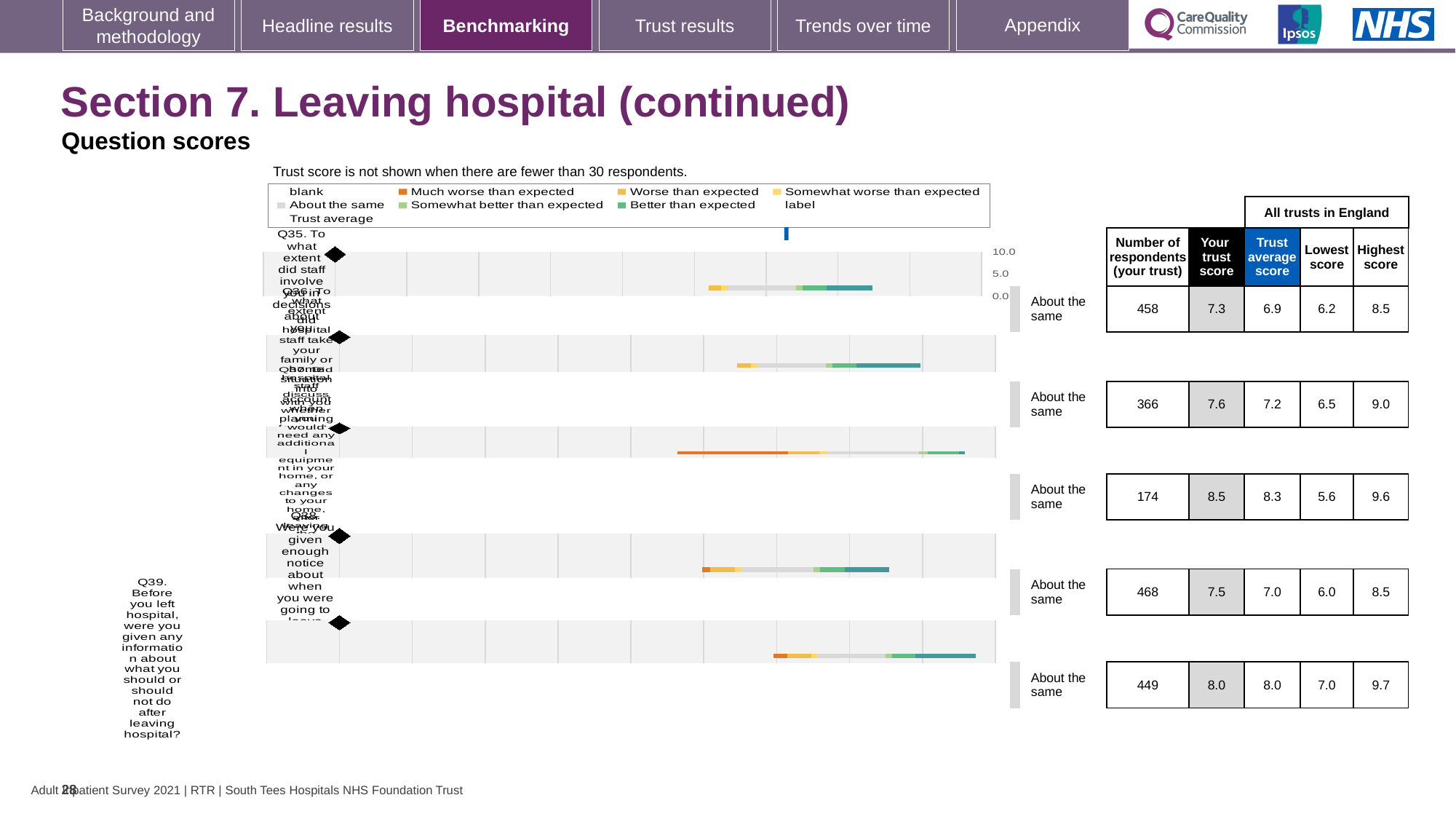
What kind of chart is used to show the question scores on this slide? bar chart Is the trust score for the fourth question (Q38) greater or less than 5.0? greater What is the trust average score for the second question (Q36)? 7.2 What is the highest value shown on the chart's score axis? 10.0 What is the difference between the trust score and the trust average score for the third question (Q37)? 0.2 Which question has the lowest number of respondents? Q37 What is the number of respondents for the last question (Q39)? 449 For the first question (Q35), which is larger: the trust score or the trust average score? trust score How many questions (rows) are plotted in the question scores chart? 5 What benchmark category is shown for every question in the chart? About the same Which question has the highest 'Your trust score' in the chart? Q37 What is the trust score for the first question (Q35) in the chart? 7.3